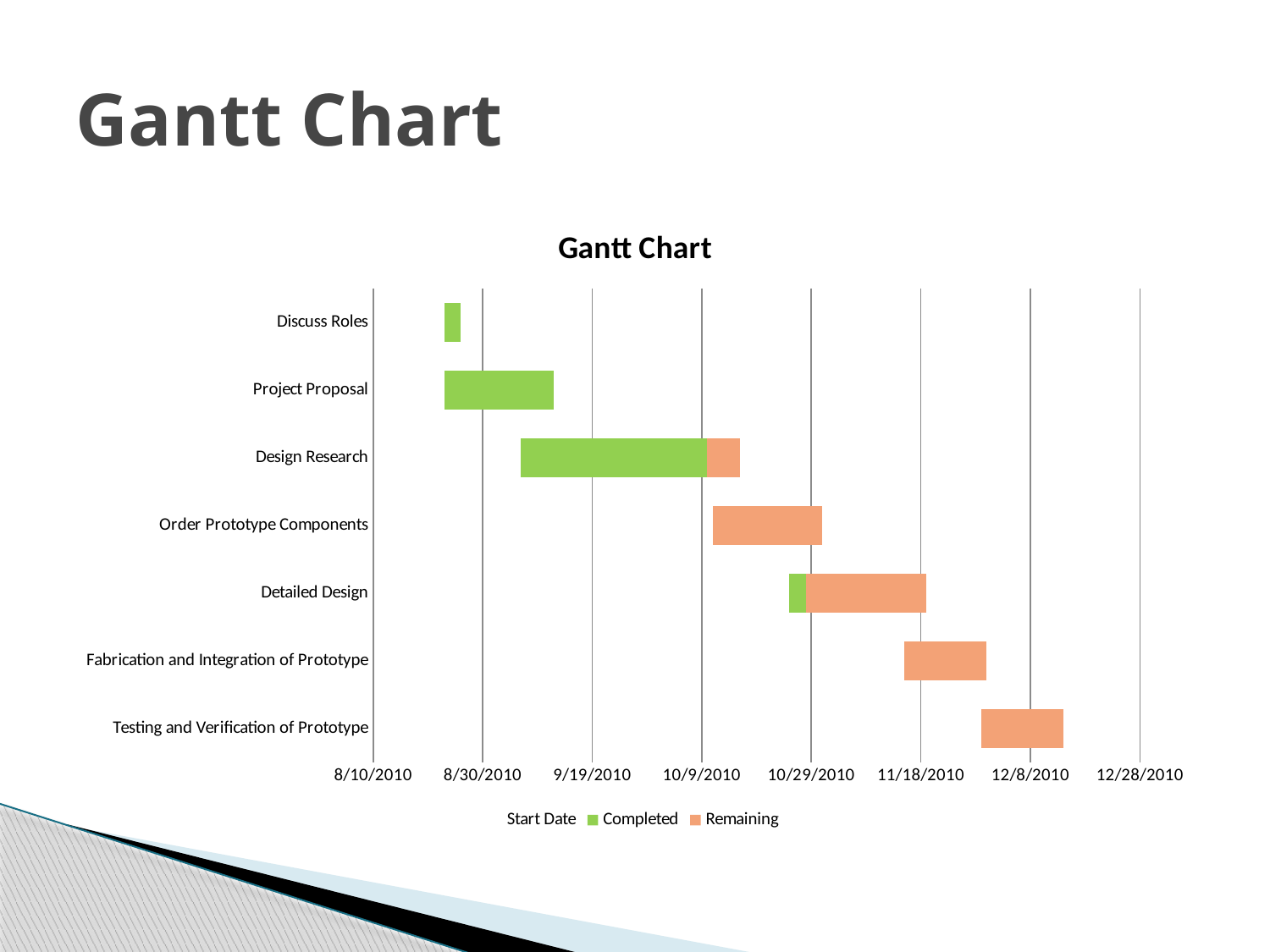
Does the bar for Project Proposal end before or after 9/19/2010? before Which task starts later: Fabrication and Integration of Prototype or Testing and Verification of Prototype? Testing and Verification of Prototype What is the title of the chart? Gantt Chart How many tasks (categories) are listed on the vertical axis of the Gantt Chart? 7 Which colour represents the Remaining series in the legend? Orange How many series does the legend of the Gantt Chart list? 3 Which bar is longer: Design Research or Project Proposal? Design Research Which task is listed first (at the top) of the Gantt Chart? Discuss Roles Which task has the shortest bar in the Gantt Chart? Discuss Roles What kind of chart is shown on the slide? Bar chart Which task has the longest bar in the Gantt Chart? Design Research Does the bar for Testing and Verification of Prototype begin before or after 11/18/2010? after